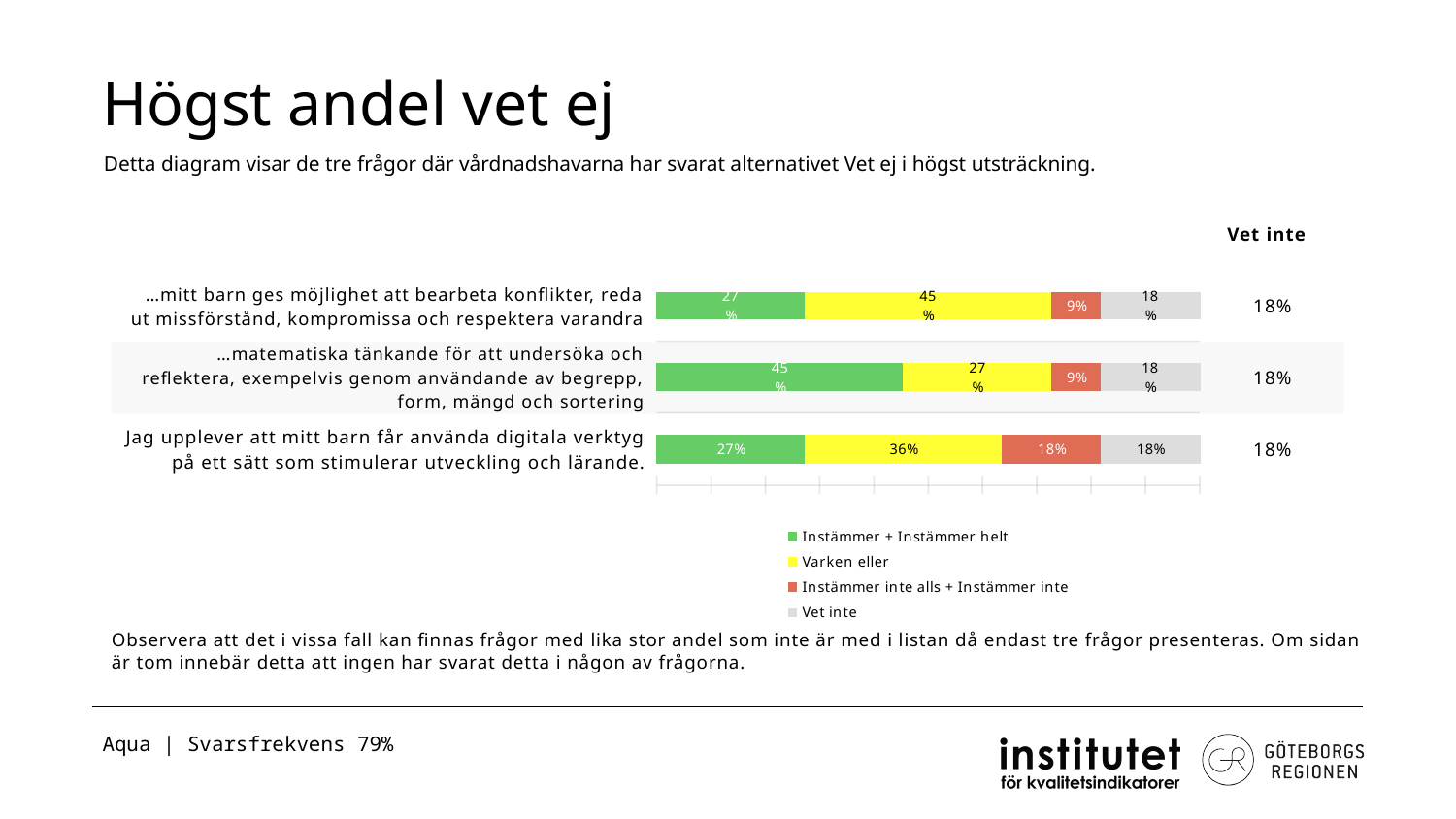
How many series does the legend list? 4 How many categories (questions) are plotted in the chart? 3 What is the 'Vet inte' value for the question 'Jag upplever att mitt barn får använda digitala verktyg…'? 18% What is the value of 'Instämmer + Instämmer helt' for the question '…matematiska tänkande för att undersöka och reflektera…'? 45% Which question has the highest 'Instämmer + Instämmer helt' value? …matematiska tänkande för att undersöka och reflektera, exempelvis genom användande av begrepp, form, mängd och sortering What kind of chart is shown on the slide? stacked bar chart What is the difference between the 'Varken eller' values for the '…mitt barn ges möjlighet att bearbeta konflikter…' question and the 'Jag upplever att mitt barn får använda digitala verktyg…' question? 9% What is the value of 'Instämmer inte alls + Instämmer inte' for the question '…mitt barn ges möjlighet att bearbeta konflikter…'? 9% Which question has the highest 'Instämmer inte alls + Instämmer inte' value? Jag upplever att mitt barn får använda digitala verktyg på ett sätt som stimulerar utveckling och lärande. Is the 'Instämmer inte alls + Instämmer inte' value larger for the '…matematiska tänkande…' question or the 'Jag upplever att mitt barn får använda digitala verktyg…' question? Jag upplever att mitt barn får använda digitala verktyg… What is the value of 'Varken eller' for the question 'Jag upplever att mitt barn får använda digitala verktyg…'? 36% Which legend entry is shown in grey? Vet inte